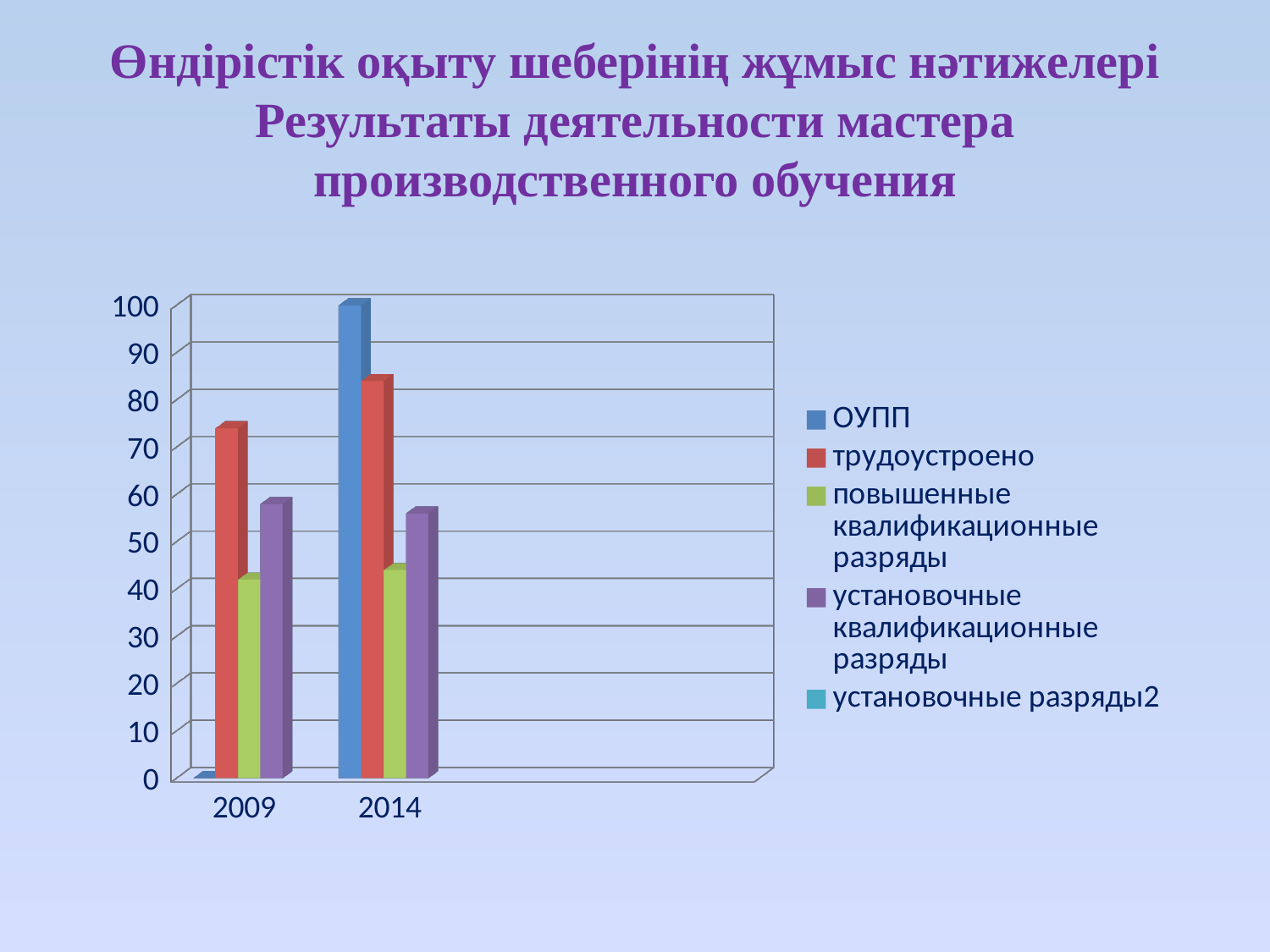
Is the value for ОУПП in 2014 greater or less than 90? greater Which years are shown on the x axis? 2009 and 2014 How many categories are shown on the x axis? 2 Is the value for трудоустроено in 2009 greater or less than 60? greater Does the value for ОУПП rise or fall from 2009 to 2014? rise Which series has the lowest value in 2009? ОУПП Is the value for ОУПП in 2009 greater or less than 10? less What kind of chart is shown on the slide? bar chart Which series has the highest value in 2014? ОУПП Which is larger for трудоустроено: the value in 2009 or in 2014? 2014 How many series does the legend list? 5